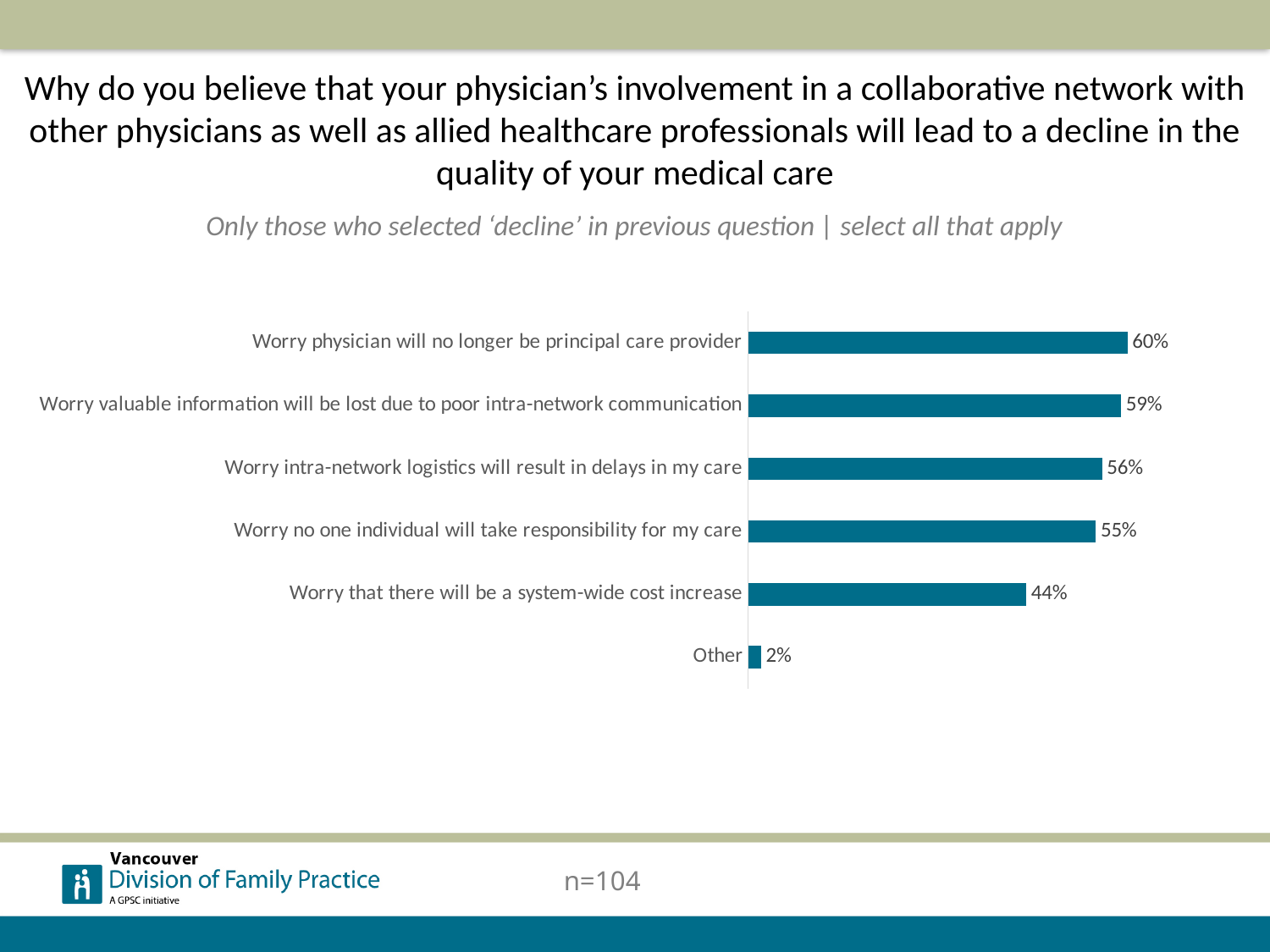
Which is larger: 'Worry valuable information will be lost due to poor intra-network communication' or 'Worry that there will be a system-wide cost increase'? Worry valuable information will be lost due to poor intra-network communication What kind of chart is shown on the slide? Bar chart What percentage selected 'Other'? 2% How many categories are shown in the chart? 6 What percentage of respondents selected 'Worry physician will no longer be principal care provider'? 60% What is the value for 'Worry that there will be a system-wide cost increase'? 44% What is the difference between 'Worry no one individual will take responsibility for my care' and 'Other'? 53% Which category has the highest value? Worry physician will no longer be principal care provider What is the difference between 'Worry physician will no longer be principal care provider' and 'Worry that there will be a system-wide cost increase'? 16% What is the sample size (n) shown on the slide? n=104 Which category has the lowest value? Other What is the value for 'Worry intra-network logistics will result in delays in my care'? 56%